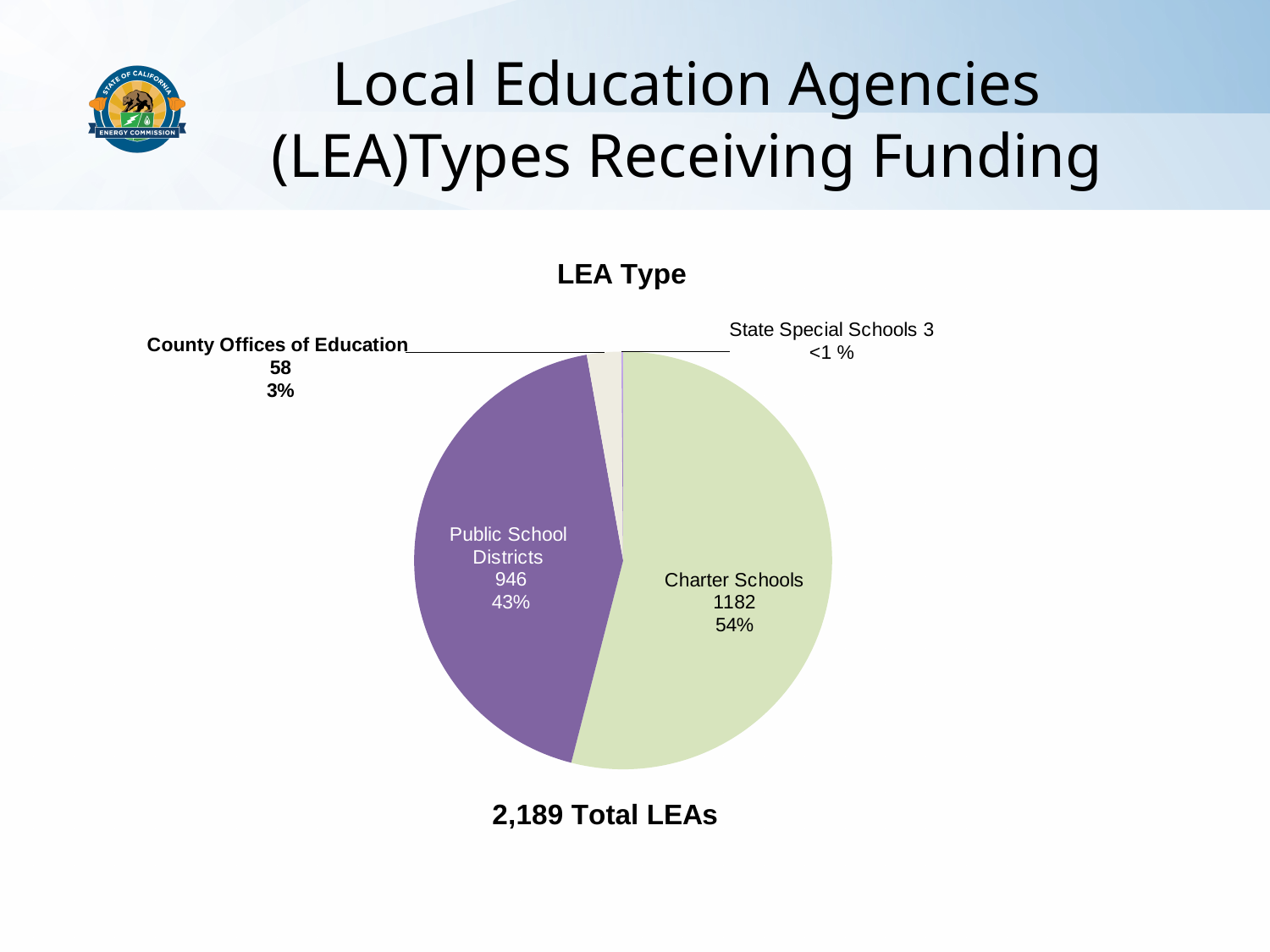
How many more Charter Schools than Public School Districts are there? 236 What type of chart is shown on the slide? pie chart How many LEAs are Public School Districts? 946 What share of the pie do Charter Schools represent? 54% Which LEA type has the smallest slice? State Special Schools Which LEA type has the largest slice? Charter Schools What share of the pie do Public School Districts represent? 43% How many LEAs are State Special Schools? 3 What is the title of the chart? LEA Type How many LEAs are County Offices of Education? 58 How many LEA types are shown in the pie chart? 4 How many LEAs are Charter Schools? 1182